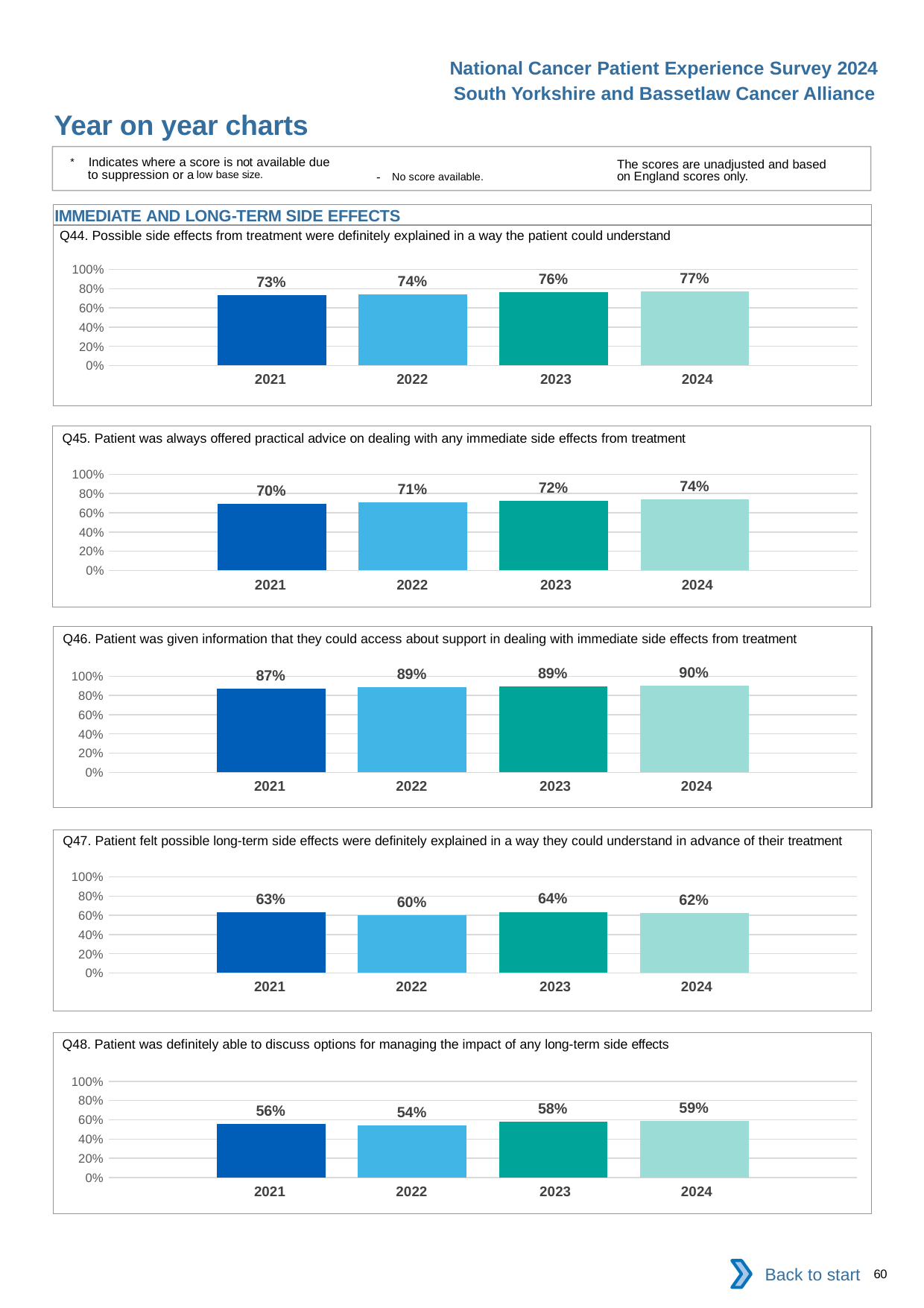
In the Q47 chart, is the value for 2022 larger or smaller than the value for 2024? smaller How many charts are shown on the slide? 5 In the Q44 chart, what is the value for 2024? 77% In the Q48 chart, is the value for 2024 greater or less than 40%? greater In the Q46 chart, what is the difference between the 2024 value and the 2021 value? 3% In the Q45 chart, what is the difference between the 2023 value and the 2022 value? 1% In the Q44 chart, do the values rise or fall from 2021 to 2024? rise What kind of chart is the Q46 chart? bar chart In the Q48 chart, what is the value for 2022? 54% How many years are shown in the Q45 chart? 4 In the Q47 chart, which year has the highest value? 2023 In the Q45 chart, which year has the lowest value? 2021